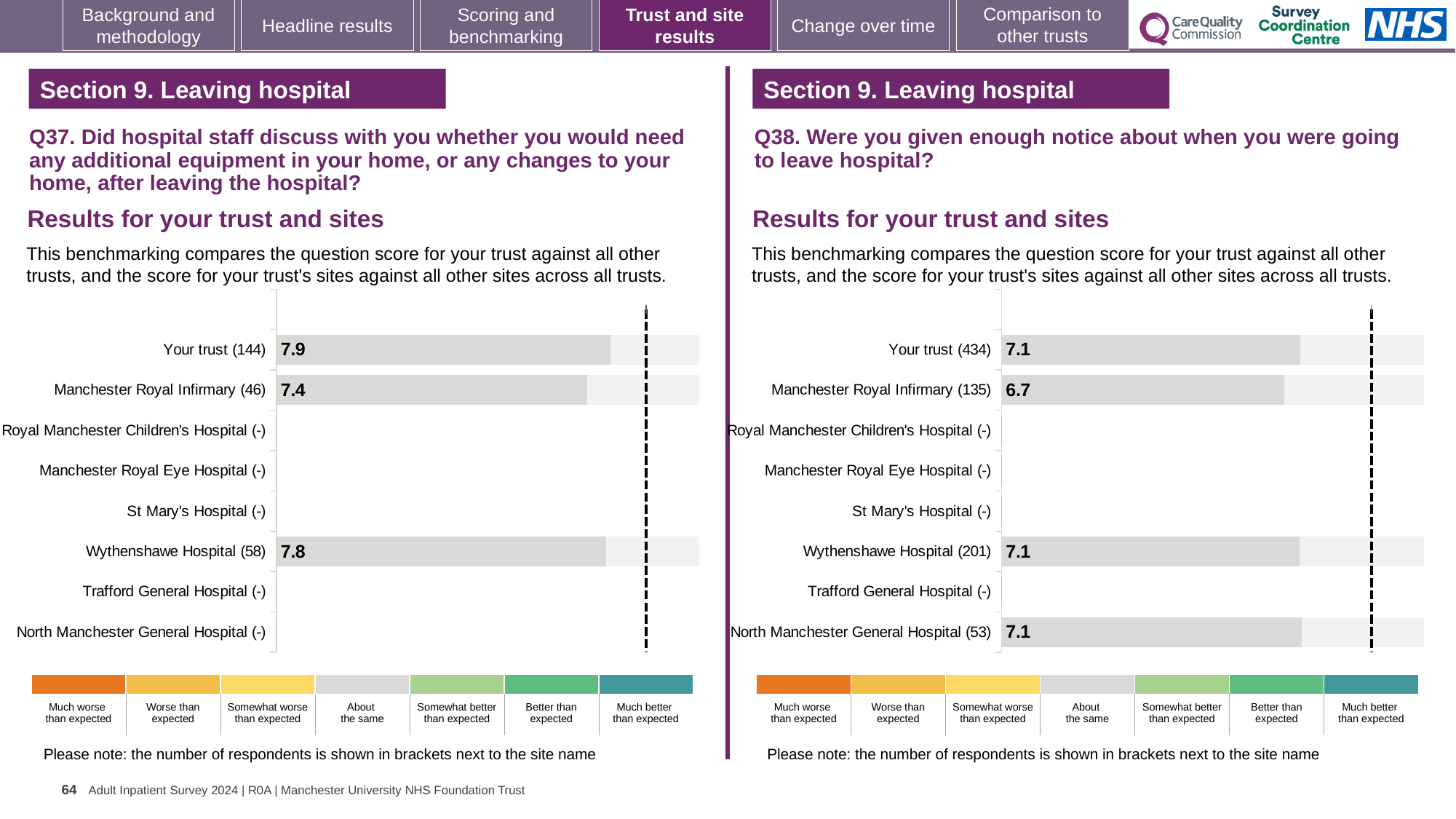
Is the score for Wythenshawe Hospital larger in the Q37 chart on the left or the Q38 chart on the right? Q37 chart on the left In the Q37 chart on the left, what is the score for Your trust? 7.9 In the Q37 chart on the left, what is the difference between the scores for Your trust and Manchester Royal Infirmary? 0.5 In the Q38 chart on the right, what is the score for North Manchester General Hospital? 7.1 In the Q38 chart on the right, what is the difference between the scores for Your trust and Manchester Royal Infirmary? 0.4 In the Q38 chart on the right, what is the score for Manchester Royal Infirmary? 6.7 In the Q38 chart on the right, which site has the lowest score shown? Manchester Royal Infirmary In the Q37 chart on the left, what is the score for Wythenshawe Hospital? 7.8 In the Q37 chart on the left, what is the score for Manchester Royal Infirmary? 7.4 What kind of chart is used in the Q37 chart on the left? Bar chart How many respondents are shown in brackets for Your trust in the Q38 chart on the right? 434 In the Q37 chart on the left, which site or trust has the lowest score shown? Manchester Royal Infirmary